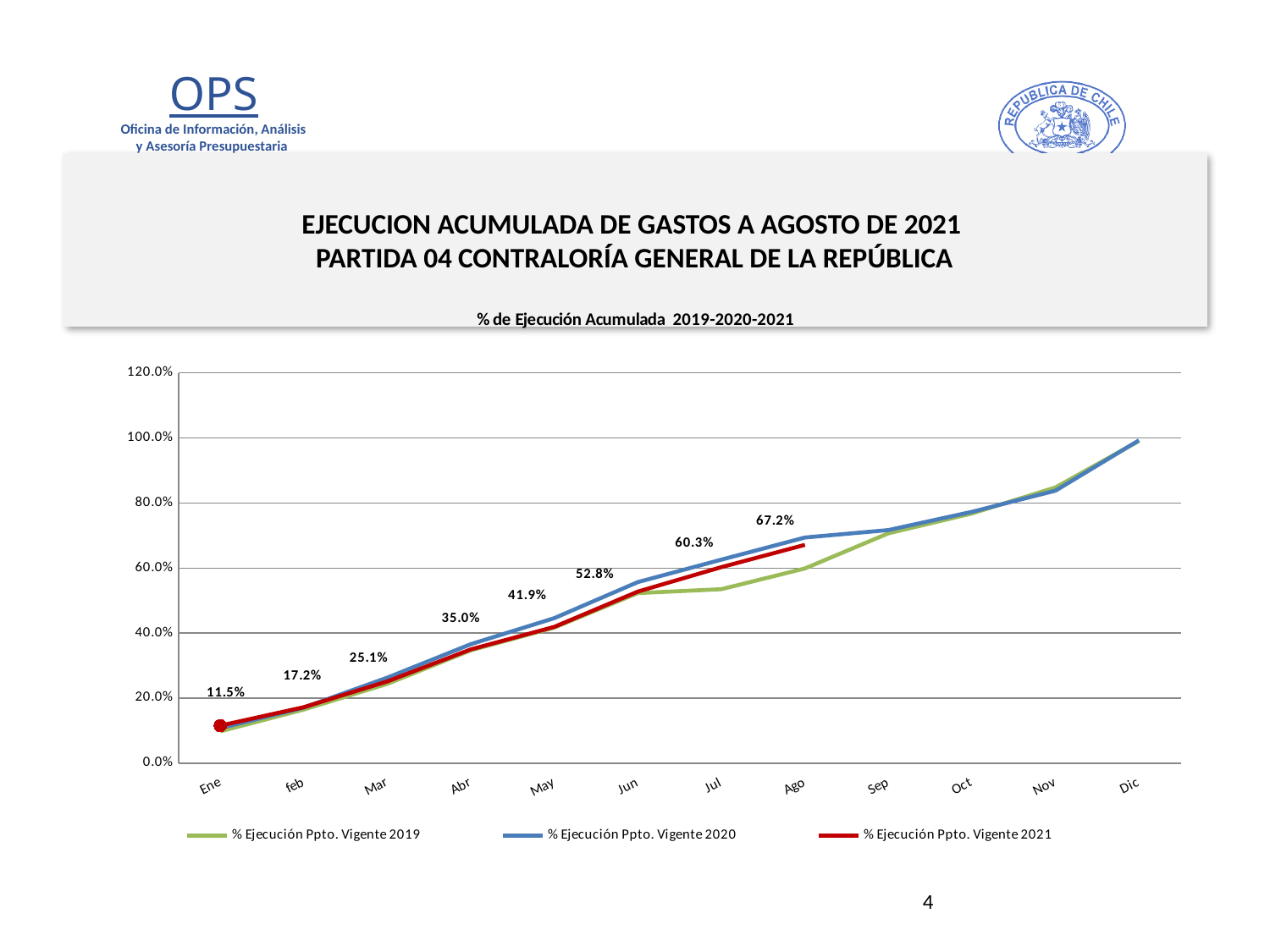
Does the % Ejecución Ppto. Vigente 2021 line rise or fall from Ene to Ago? rise What is the value of % Ejecución Ppto. Vigente 2021 for Ago? 67.2% How many series does the legend list? 3 What is the difference between the 2021 values for Ago and Jul? 6.9% What is the value of % Ejecución Ppto. Vigente 2021 for May? 41.9% What type of chart is shown on the slide? line chart What is the value of % Ejecución Ppto. Vigente 2021 for Ene? 11.5% How many months are shown on the x axis? 12 Is the value of % Ejecución Ppto. Vigente 2020 for Dic greater or less than 80.0%? greater What is the title of the chart? % de Ejecución Acumulada 2019-2020-2021 What is the difference between the 2021 values for Jun and Ene? 41.3% Which series is higher in Ago, % Ejecución Ppto. Vigente 2019 or % Ejecución Ppto. Vigente 2020? % Ejecución Ppto. Vigente 2020